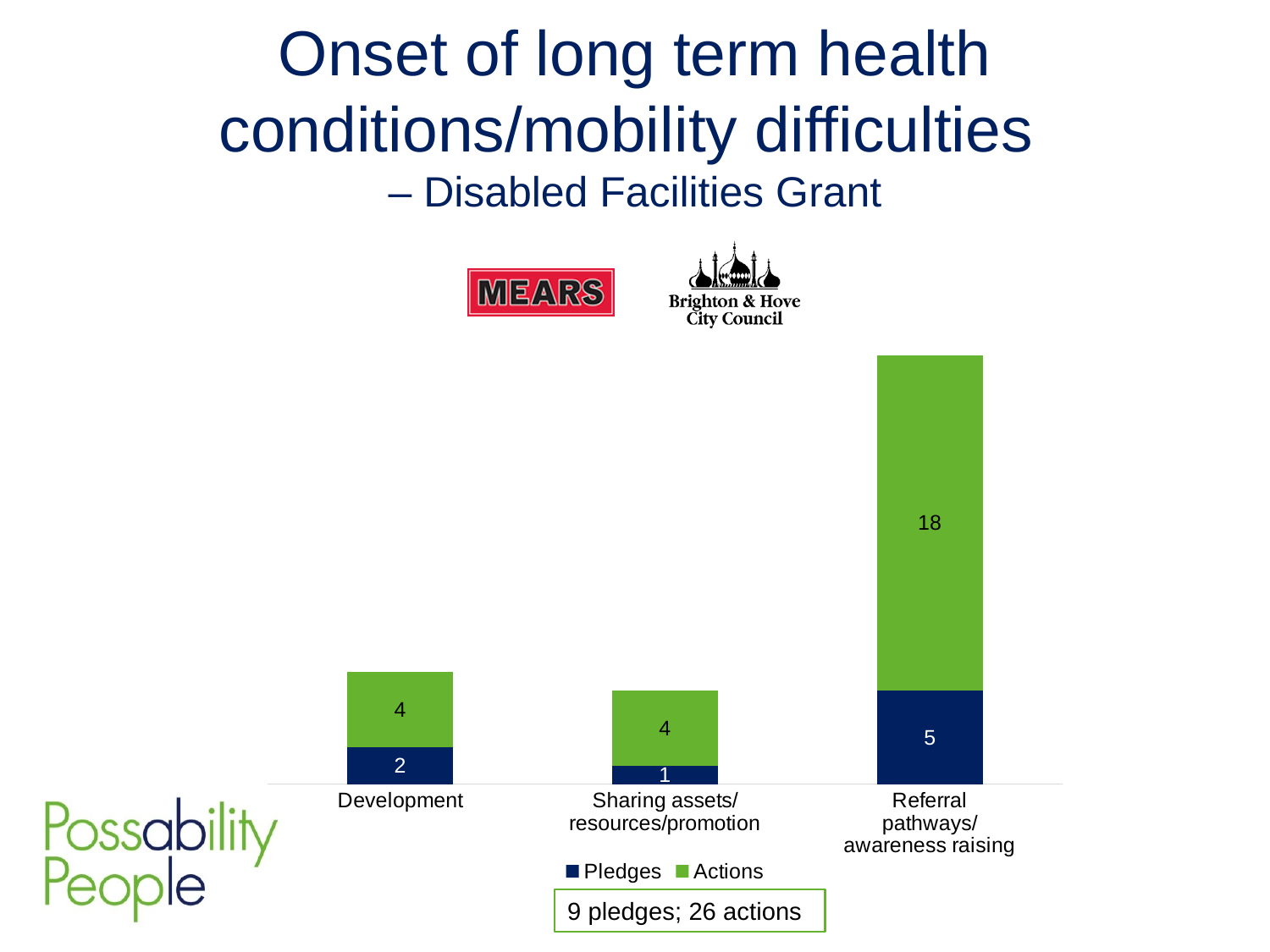
Which is larger: the Pledges for Referral pathways/awareness raising or the Pledges for Development? Referral pathways/awareness raising How many Pledges are shown for Sharing assets/resources/promotion? 1 What is the difference between the Actions for Referral pathways/awareness raising and the Actions for Development? 14 How many series does the legend list? 2 How many Pledges are shown for Development? 2 How many categories are shown on the x axis? 3 What is the total of the stacked bar for Development? 6 What kind of chart is shown on the slide? Stacked bar chart Which category has the lowest number of Pledges? Sharing assets/resources/promotion Which category has the highest number of Actions? Referral pathways/awareness raising What is the total of the stacked bar for Referral pathways/awareness raising? 23 How many Actions are shown for Referral pathways/awareness raising? 18